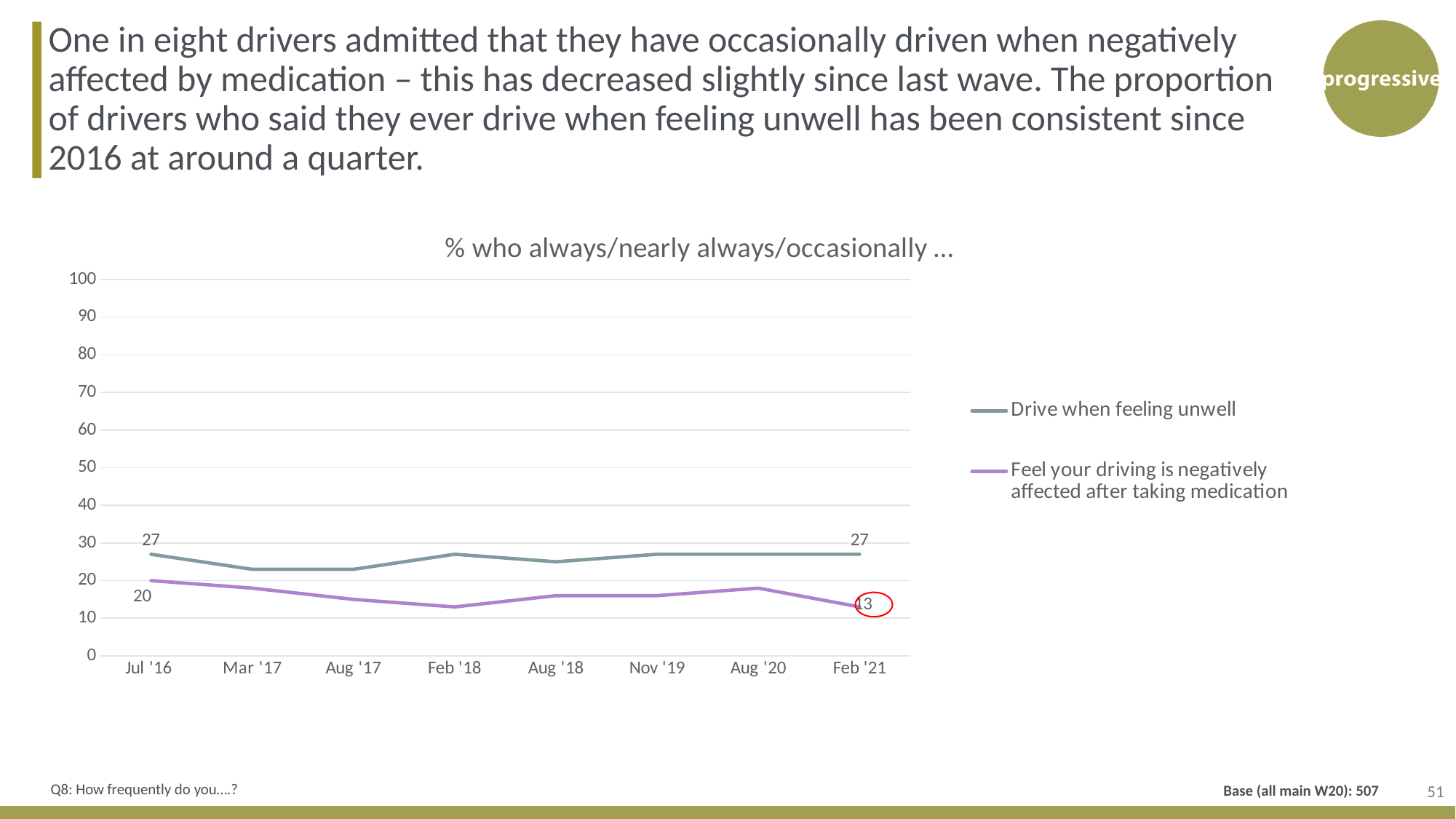
What is the value for 'Feel your driving is negatively affected after taking medication' at Jul '16? 20 Is the value for 'Drive when feeling unwell' at Aug '20 greater or less than 20? greater Which series is higher at Feb '21? Drive when feeling unwell What is the title of the chart? % who always/nearly always/occasionally ... What is the value for 'Feel your driving is negatively affected after taking medication' at Feb '21? 13 By how much did the 'Feel your driving is negatively affected after taking medication' value change from Jul '16 to Feb '21? 7 How many time points are plotted along the x axis? 8 What is the difference between the two series at Feb '21? 14 How many series does the legend list? 2 What is the value for 'Drive when feeling unwell' at Feb '21? 27 What type of chart is shown on the slide? line chart What is the value for 'Drive when feeling unwell' at Jul '16? 27